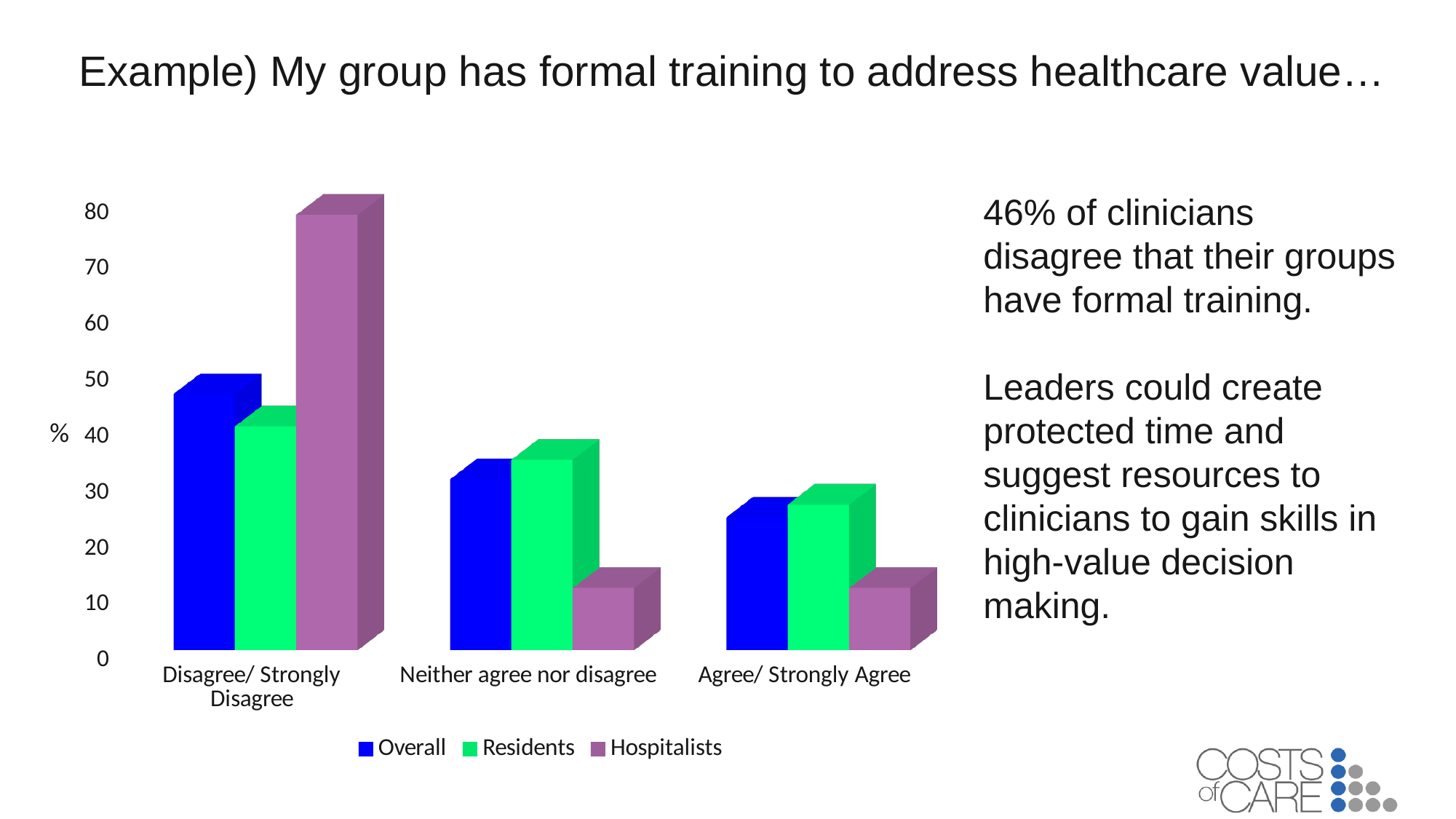
Is the Overall value for Agree/ Strongly Agree greater or less than 30? less Do the Overall values rise or fall moving from Disagree/ Strongly Disagree to Agree/ Strongly Agree? fall How many response categories are shown on the x axis? 3 How many series does the legend list? 3 Which series has the highest bar in the Disagree/ Strongly Disagree category? Hospitalists Is the Hospitalists value for Neither agree nor disagree greater or less than 20? less In the Disagree/ Strongly Disagree category, which is larger: Overall or Hospitalists? Hospitalists In the Neither agree nor disagree category, which is larger: Residents or Hospitalists? Residents What are the three series named in the legend? Overall, Residents, Hospitalists Is the Overall value for Disagree/ Strongly Disagree greater or less than 40? greater What kind of chart is shown on the slide? bar chart